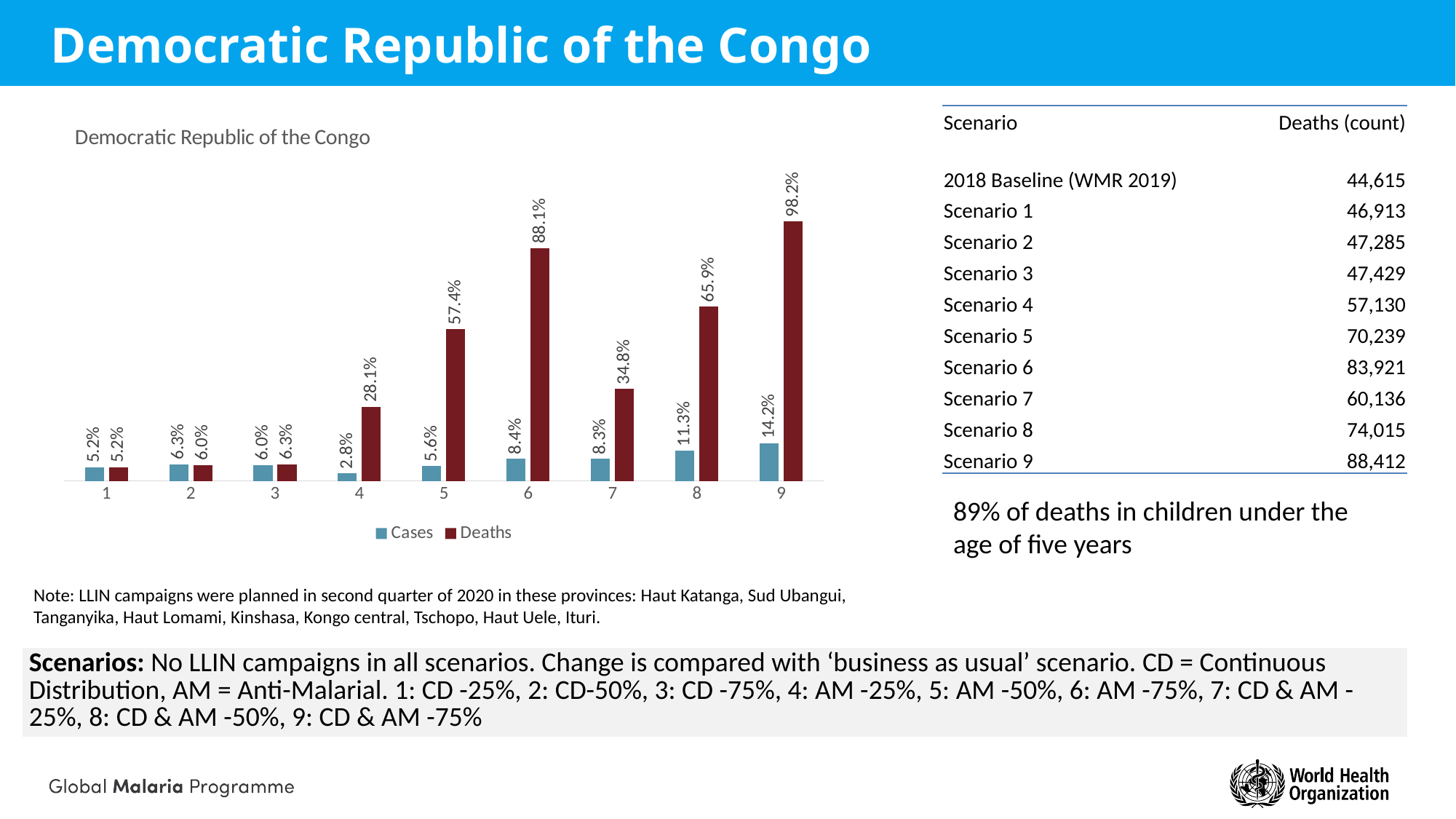
What is the Deaths value for scenario 6 in the chart? 88.1% Which is larger in the chart: the Deaths value for scenario 5 or the Deaths value for scenario 7? Deaths for scenario 5 What is the Cases value for scenario 4 in the chart? 2.8% How many scenarios are plotted on the x axis of the chart? 9 What kind of chart is shown on the slide? Bar chart What are the two series named in the chart legend? Cases and Deaths What is the Cases value for scenario 9 in the chart? 14.2% What is the difference between the Deaths and Cases values for scenario 8? 54.6% What is the Deaths value for scenario 9 in the chart? 98.2% Which scenario has the lowest Cases value in the chart? 4 Which scenario has the highest Deaths value in the chart? 9 How many series does the chart legend list? 2